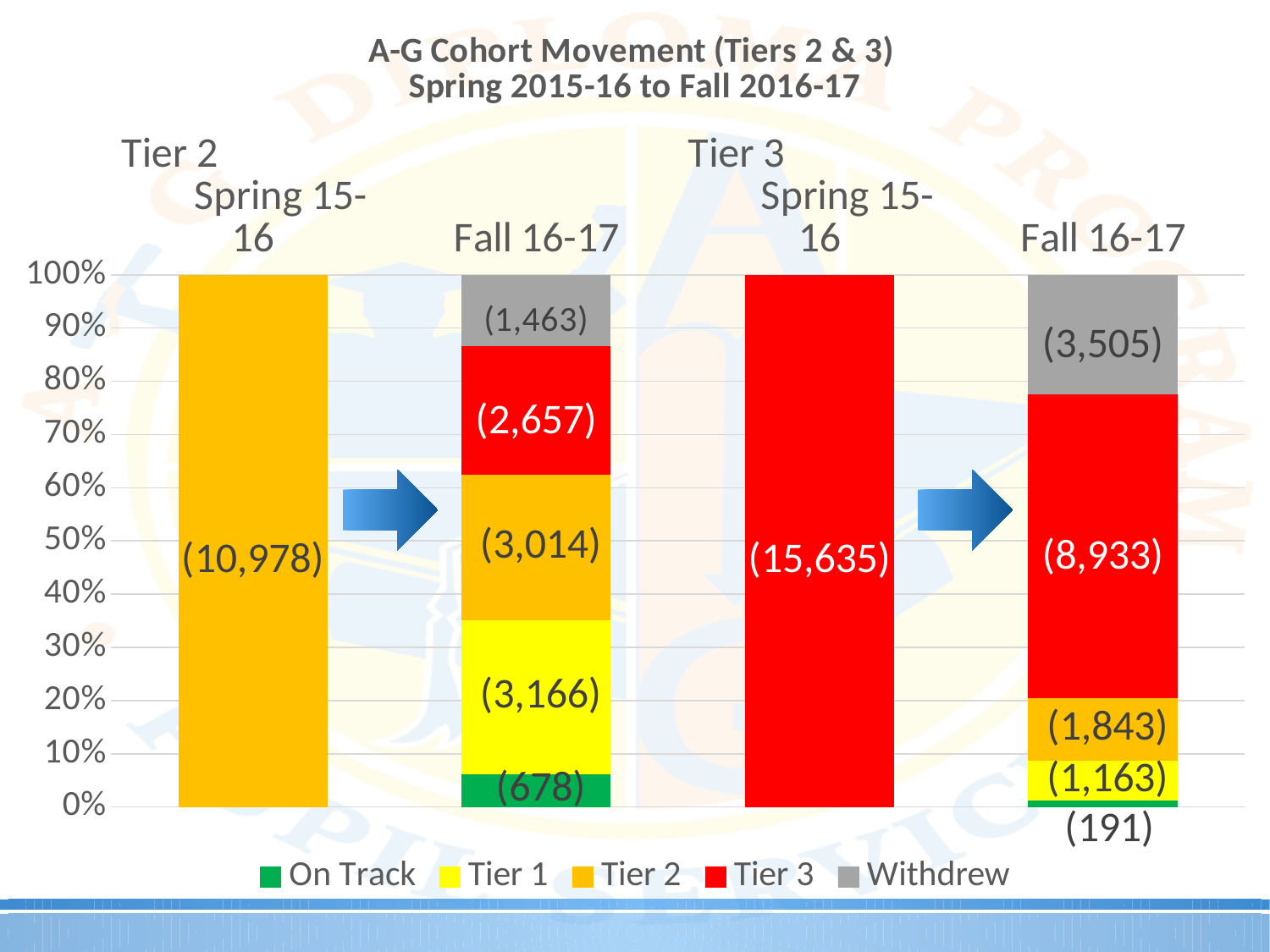
What is the On Track value in the Tier 3 Fall 16-17 bar? (191) Which is larger: the Withdrew value in the Tier 2 Fall 16-17 bar or the Withdrew value in the Tier 3 Fall 16-17 bar? Tier 3 Fall 16-17 Which legend entry is shown in grey? Withdrew What is the Tier 3 value in the Tier 3 Fall 16-17 bar? (8,933) What is the difference between the Tier 1 value in the Tier 2 Fall 16-17 bar and the Tier 1 value in the Tier 3 Fall 16-17 bar? 2,003 What is the Withdrew value in the Tier 2 Fall 16-17 bar? (1,463) How many bars are plotted in the chart? 4 How many series does the legend list? 5 What is the total of the five segments in the Tier 2 Fall 16-17 bar? 10,978 What kind of chart is shown on the slide? Stacked bar chart What is the value labelled on the Tier 3 Spring 15-16 bar? (15,635) What is the value labelled on the Tier 2 Spring 15-16 bar? (10,978)